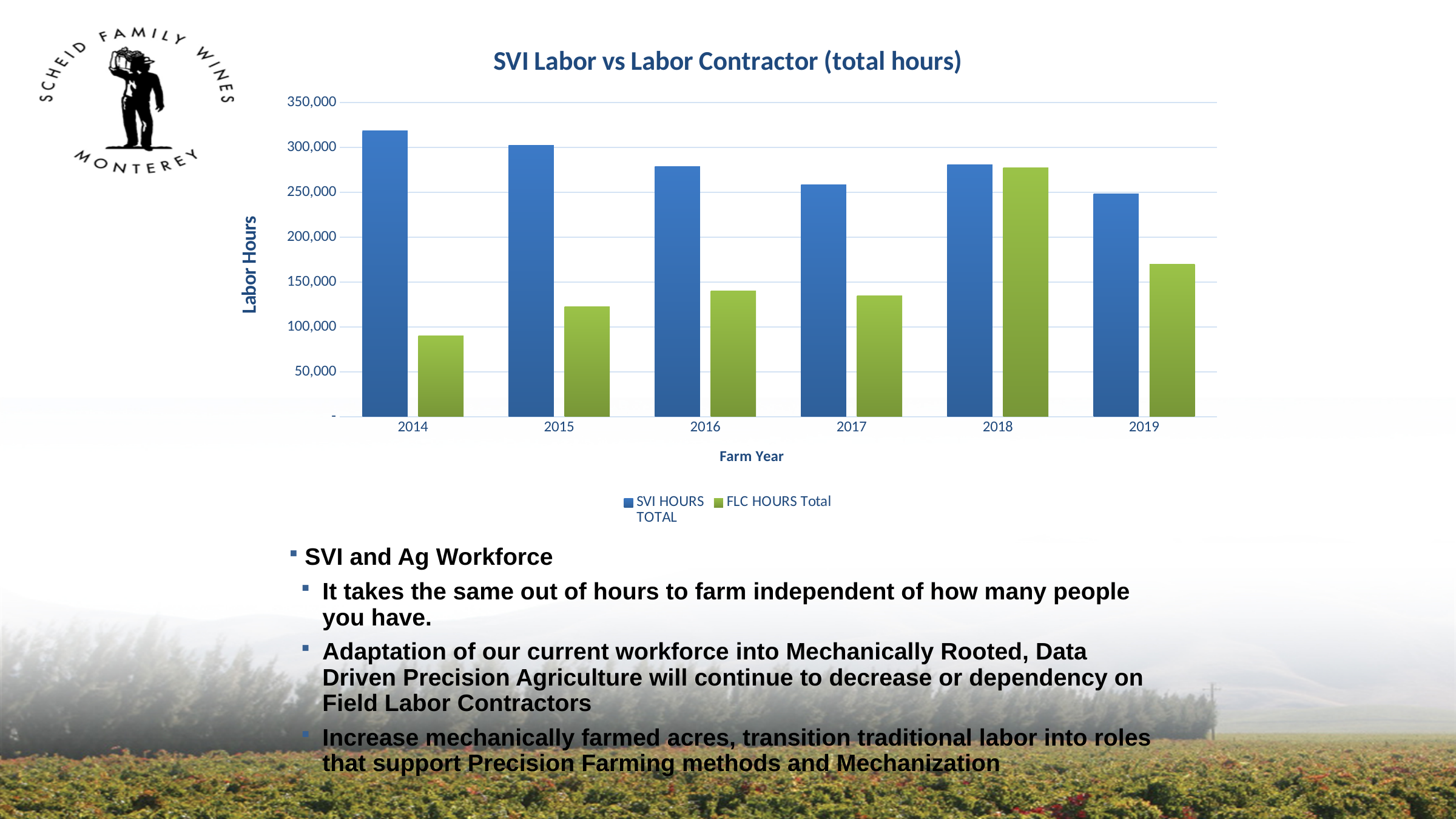
Which farm year has the lowest FLC HOURS Total? 2014 In 2014, which is larger: SVI HOURS TOTAL or FLC HOURS Total? SVI HOURS TOTAL Is the FLC HOURS Total for 2014 greater or less than 100,000? less How many series does the legend list? 2 How many farm years are shown on the x axis? 6 Is the FLC HOURS Total for 2019 greater or less than 150,000? greater What kind of chart is shown on the slide? bar chart Is the SVI HOURS TOTAL for 2014 greater or less than 300,000? greater Which farm year has the highest SVI HOURS TOTAL? 2014 What is the title of the chart? SVI Labor vs Labor Contractor (total hours) Which farm year has the highest FLC HOURS Total? 2018